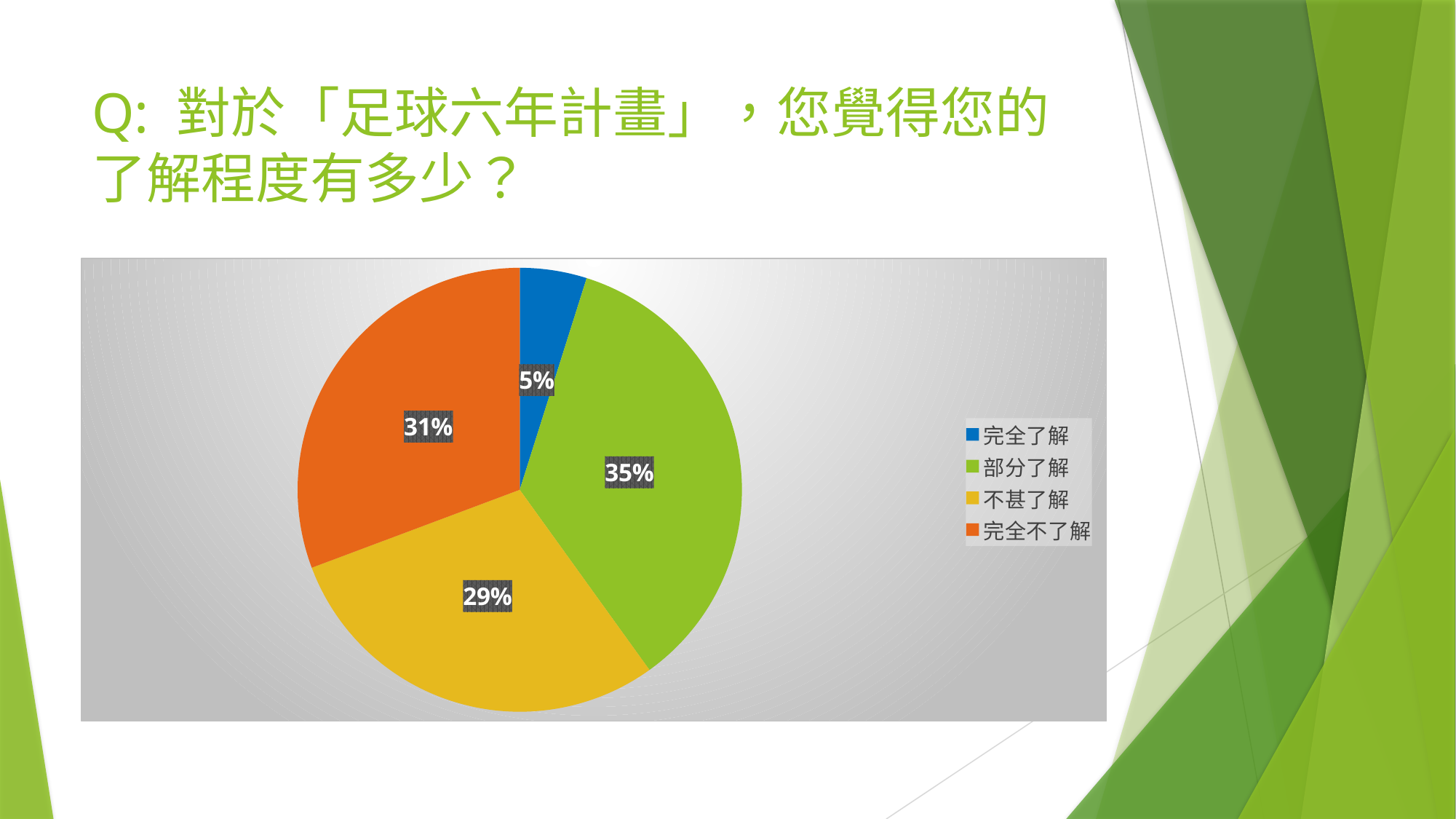
What share of the pie does 部分了解 represent? 35% What share of the pie does 完全了解 represent? 5% What colour is the slice for 不甚了解? yellow What kind of chart is shown on the slide? pie chart What is the difference in percentage points between 完全不了解 and 不甚了解? 2 What is the difference in percentage points between 部分了解 and 完全了解? 30 How many categories does the pie chart show? 4 Which category has the smallest slice of the pie? 完全了解 Which is larger, the slice for 完全不了解 or the slice for 不甚了解? 完全不了解 What share of the pie does 完全不了解 represent? 31% Which category has the largest slice of the pie? 部分了解